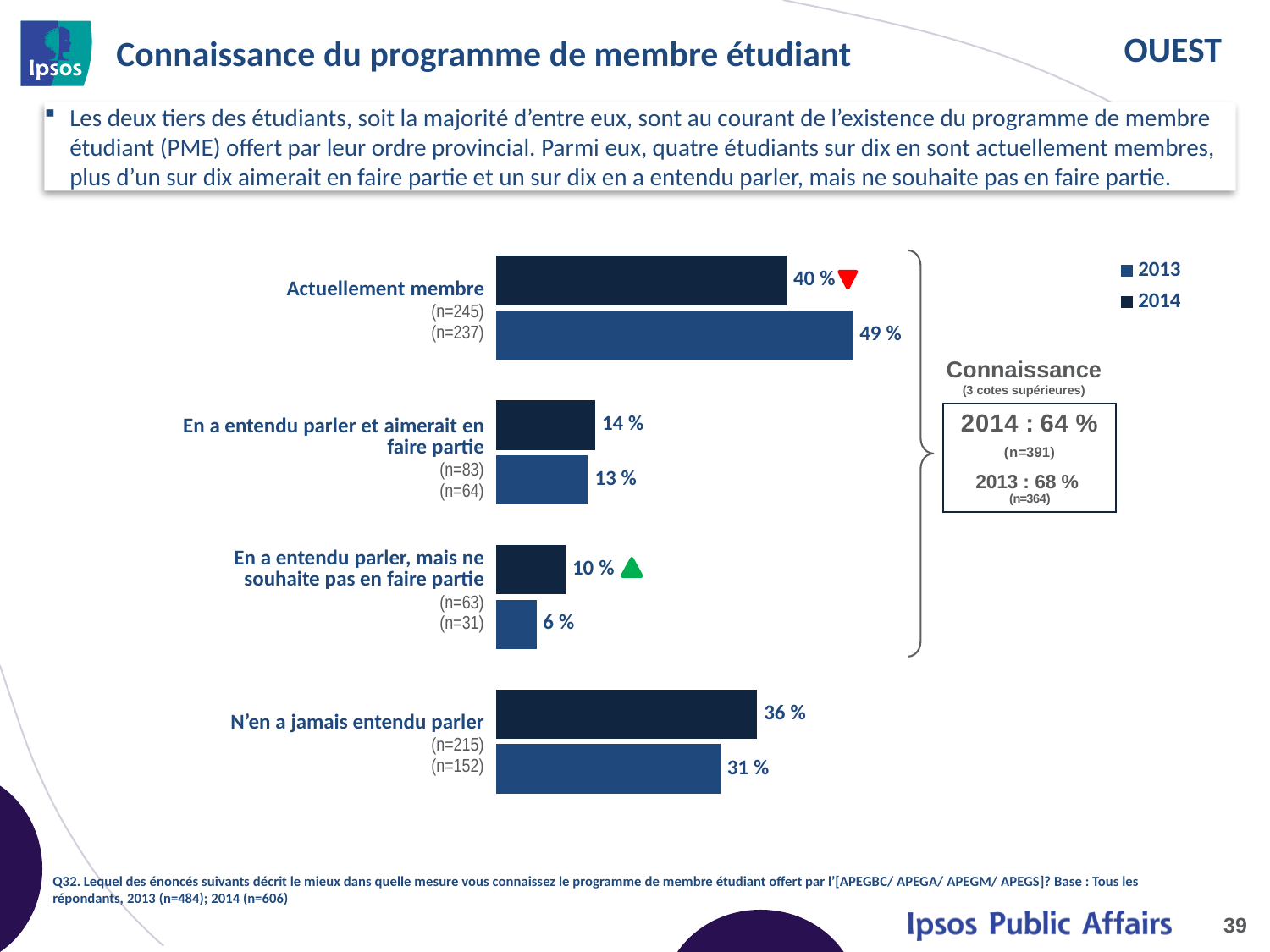
How many categories are shown in the chart? 4 What type of chart is shown on the slide? Bar chart What is the 2013 value for "En a entendu parler et aimerait en faire partie"? 13 % What is the 2014 value for "En a entendu parler, mais ne souhaite pas en faire partie"? 10 % How many series does the legend list? 2 Which series is shown in the darker navy colour in the legend? 2014 For "N'en a jamais entendu parler", which year has the larger value, 2013 or 2014? 2014 Which category has the lowest 2013 value? En a entendu parler, mais ne souhaite pas en faire partie What is the difference between the 2014 and 2013 values for "Actuellement membre"? 9 % What is the 2013 value for "N'en a jamais entendu parler"? 31 % What is the 2014 value for "Actuellement membre"? 40 % Which category has the highest 2014 value? Actuellement membre